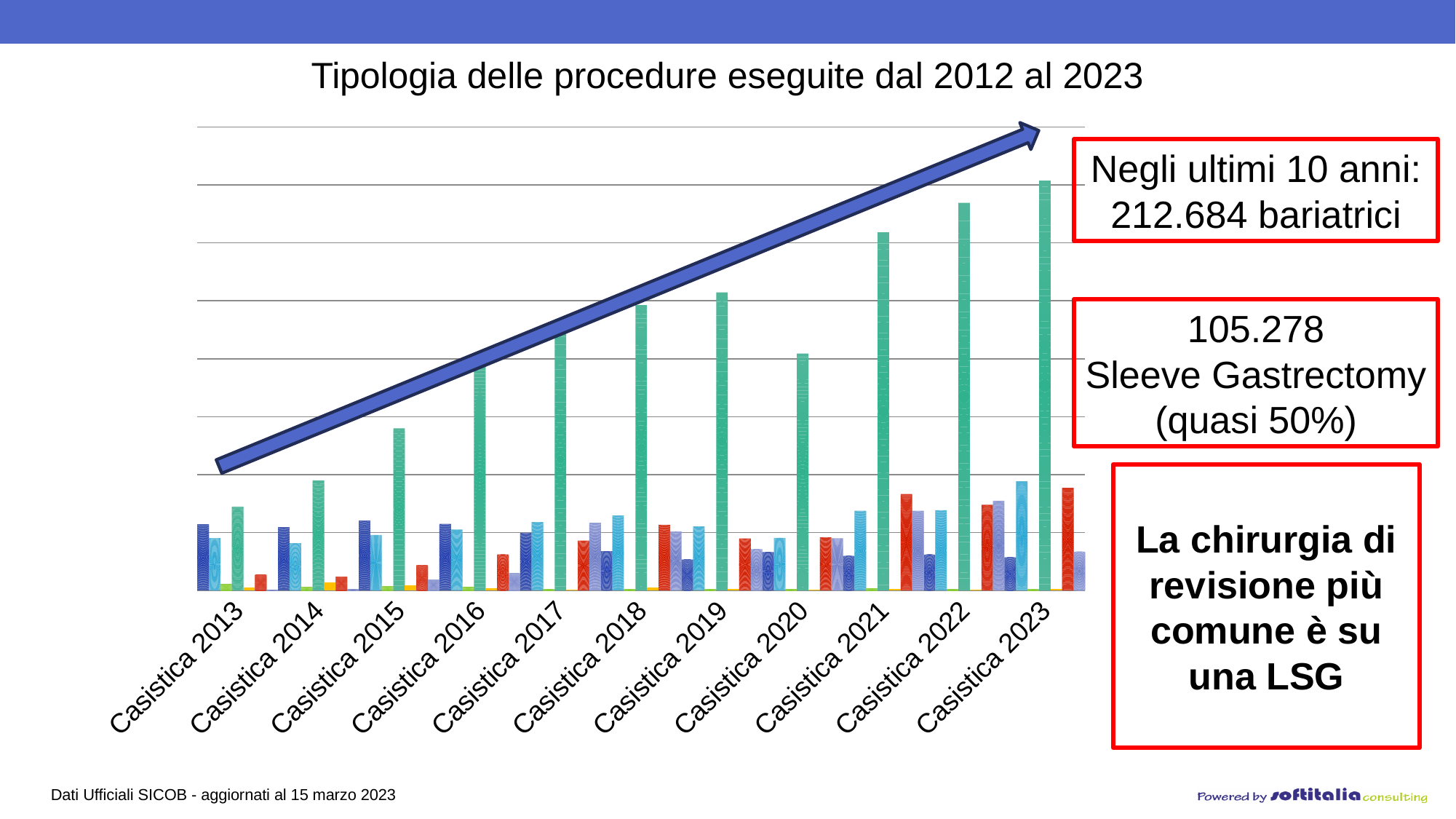
What kind of chart is shown on the slide? Bar chart Which colour of bar is the tallest in every category of the chart? Green Is the green bar for Casistica 2020 larger or smaller than the green bar for Casistica 2019? Smaller How many categories are shown along the x axis of the chart? 11 Is the green bar for Casistica 2016 larger or smaller than the green bar for Casistica 2015? Larger What is the first category on the x axis of the chart? Casistica 2013 In which category does the tallest green bar reach its highest value? Casistica 2023 Do the green bars rise or fall from Casistica 2013 to Casistica 2023? Rise What is the last category on the x axis of the chart? Casistica 2023 In which category is the green bar the lowest? Casistica 2013 Is the green bar for Casistica 2022 larger or smaller than the green bar for Casistica 2021? Larger